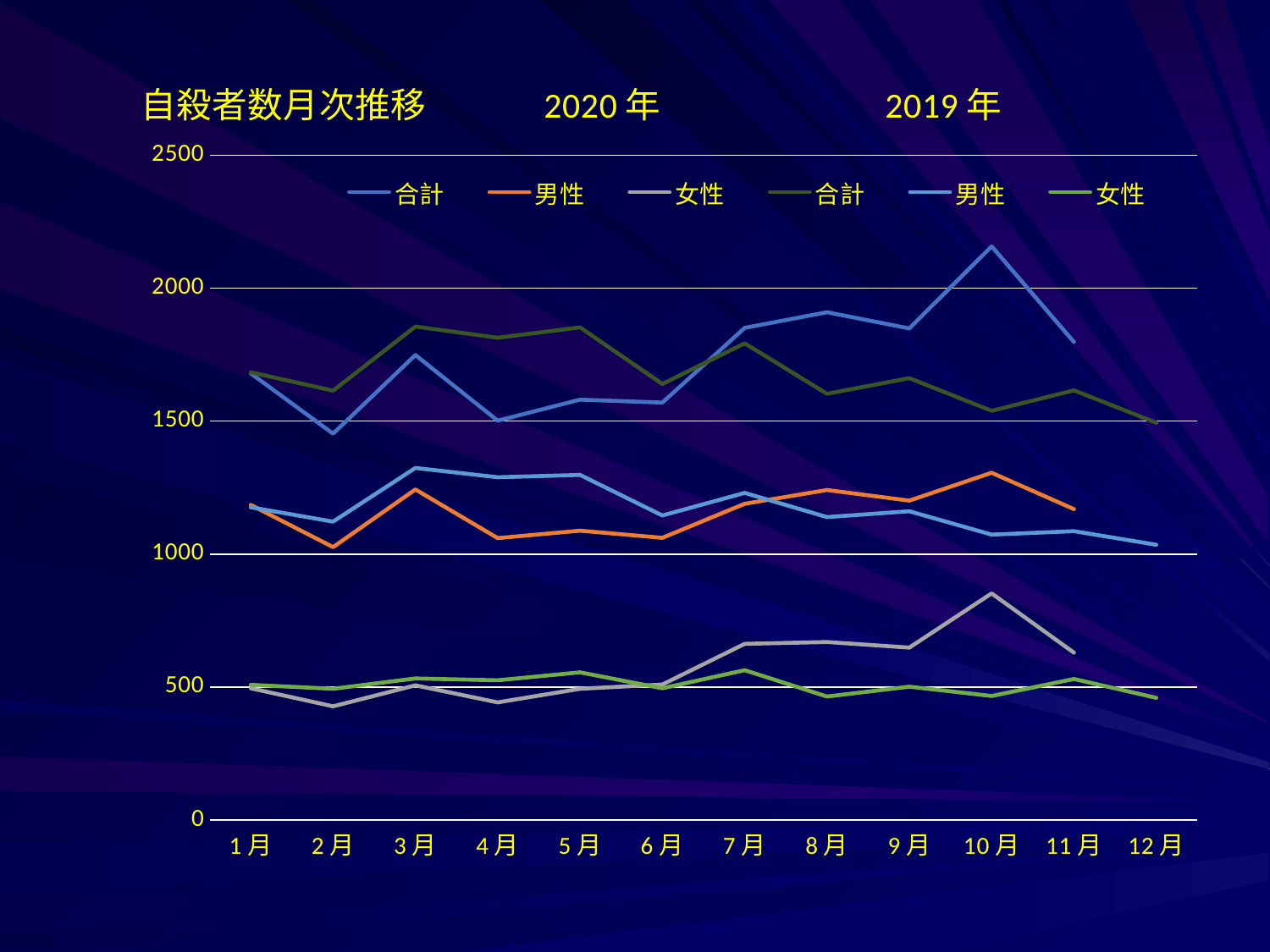
Does the 2020年 女性 series rise or fall from 6月 to 10月? rise Is the value of the 2020年 女性 series in 10月 greater or less than 1000? less In which month does the 2020年 女性 series reach its highest value? 10月 In which month does the 2020年 合計 series reach its highest value? 10月 Is the value of the 2020年 合計 series in 10月 greater or less than 2000? greater What kind of chart is shown on the slide? line chart In 10月, which is larger: the 2020年 合計 value or the 2019年 合計 value? 2020年 合計 Is the value of the 2020年 合計 series in 2月 greater or less than 1500? less How many months are shown along the x axis? 12 How many series does the legend list? 6 In 3月, which is larger: the 2020年 合計 value or the 2019年 合計 value? 2019年 合計 What is the title of the chart? 自殺者数月次推移